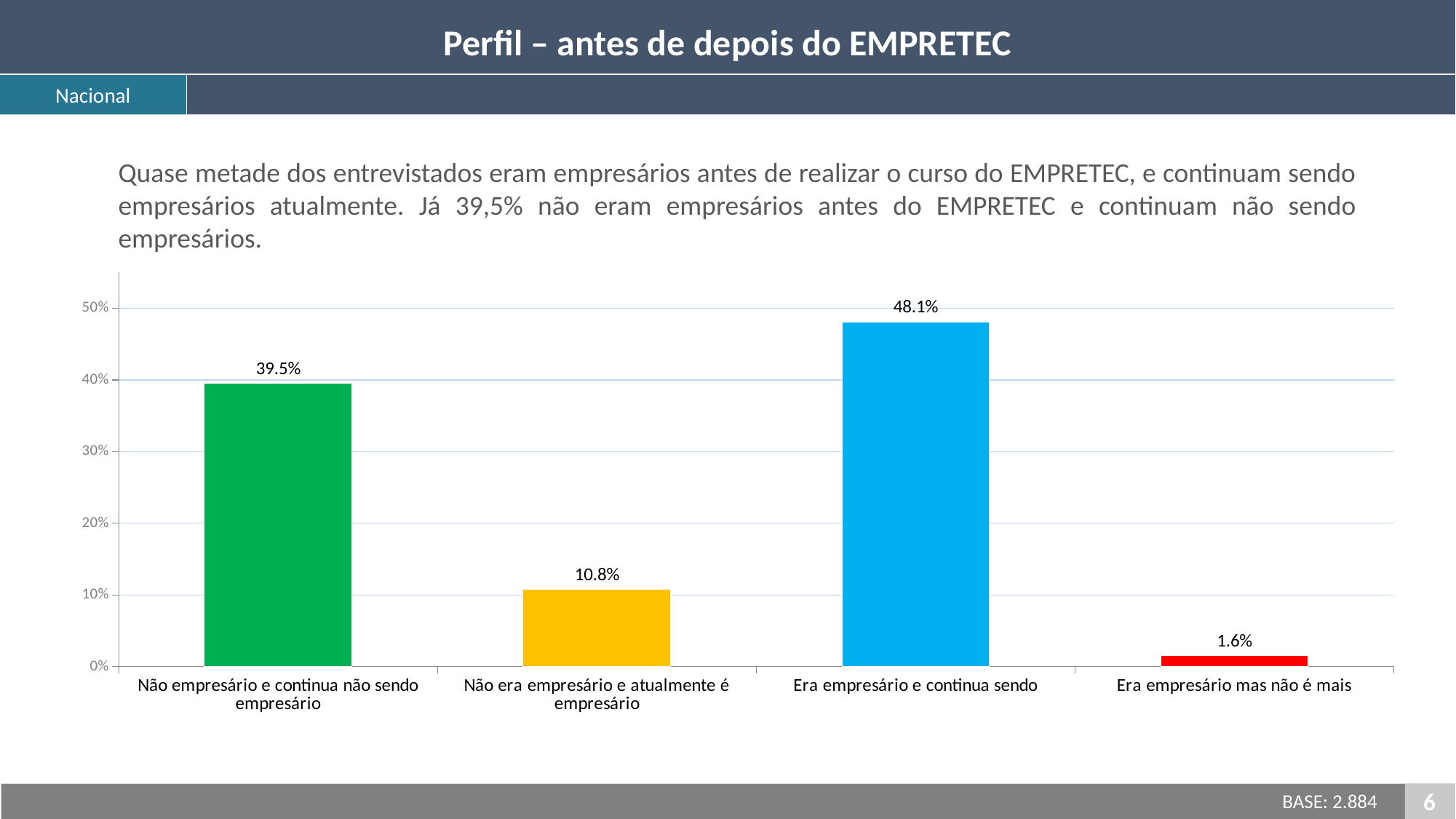
What colour is the bar for "Era empresário e continua sendo"? Blue How many categories are shown in the chart? 4 What is the difference between "Era empresário e continua sendo" and "Não empresário e continua não sendo empresário"? 8.6% What is the value for "Não empresário e continua não sendo empresário"? 39.5% What is the value for "Era empresário mas não é mais"? 1.6% Which category has the highest value? Era empresário e continua sendo Which category has the lowest value? Era empresário mas não é mais What kind of chart is shown on the slide? Bar chart What is the value for "Não era empresário e atualmente é empresário"? 10.8% Which is larger: "Não era empresário e atualmente é empresário" or "Era empresário mas não é mais"? Não era empresário e atualmente é empresário What is the value for "Era empresário e continua sendo"? 48.1% Is the value for "Não empresário e continua não sendo empresário" greater or less than 30%? greater